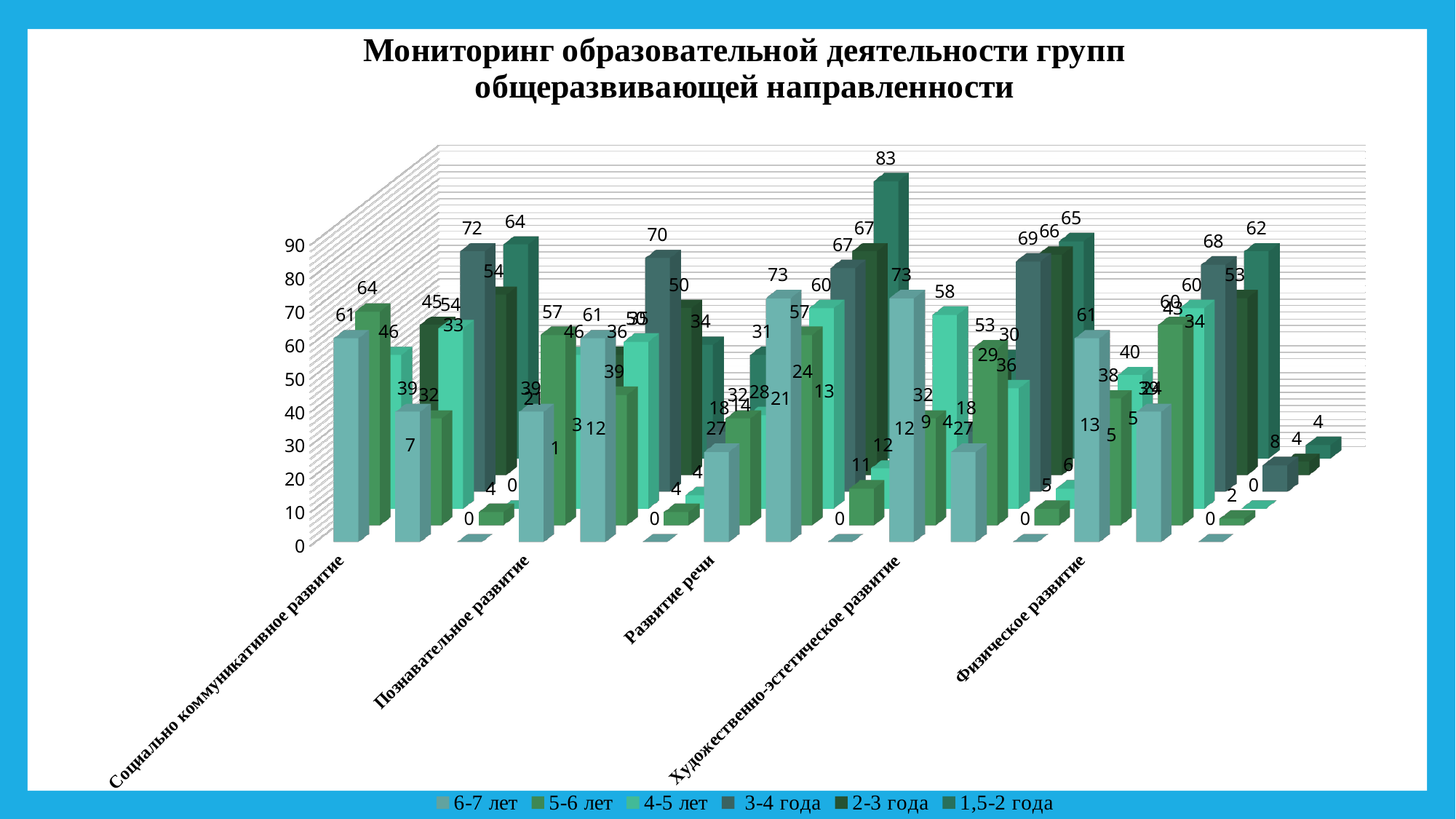
What kind of chart is shown on the slide? bar chart Which series is listed first in the legend? 6-7 лет What is the title of the chart? Мониторинг образовательной деятельности групп общеразвивающей направленности What is the highest data label value shown anywhere on the chart? 83 How many series does the legend list? 6 How many categories are shown along the x axis? 5 What is the maximum value shown on the vertical axis? 90